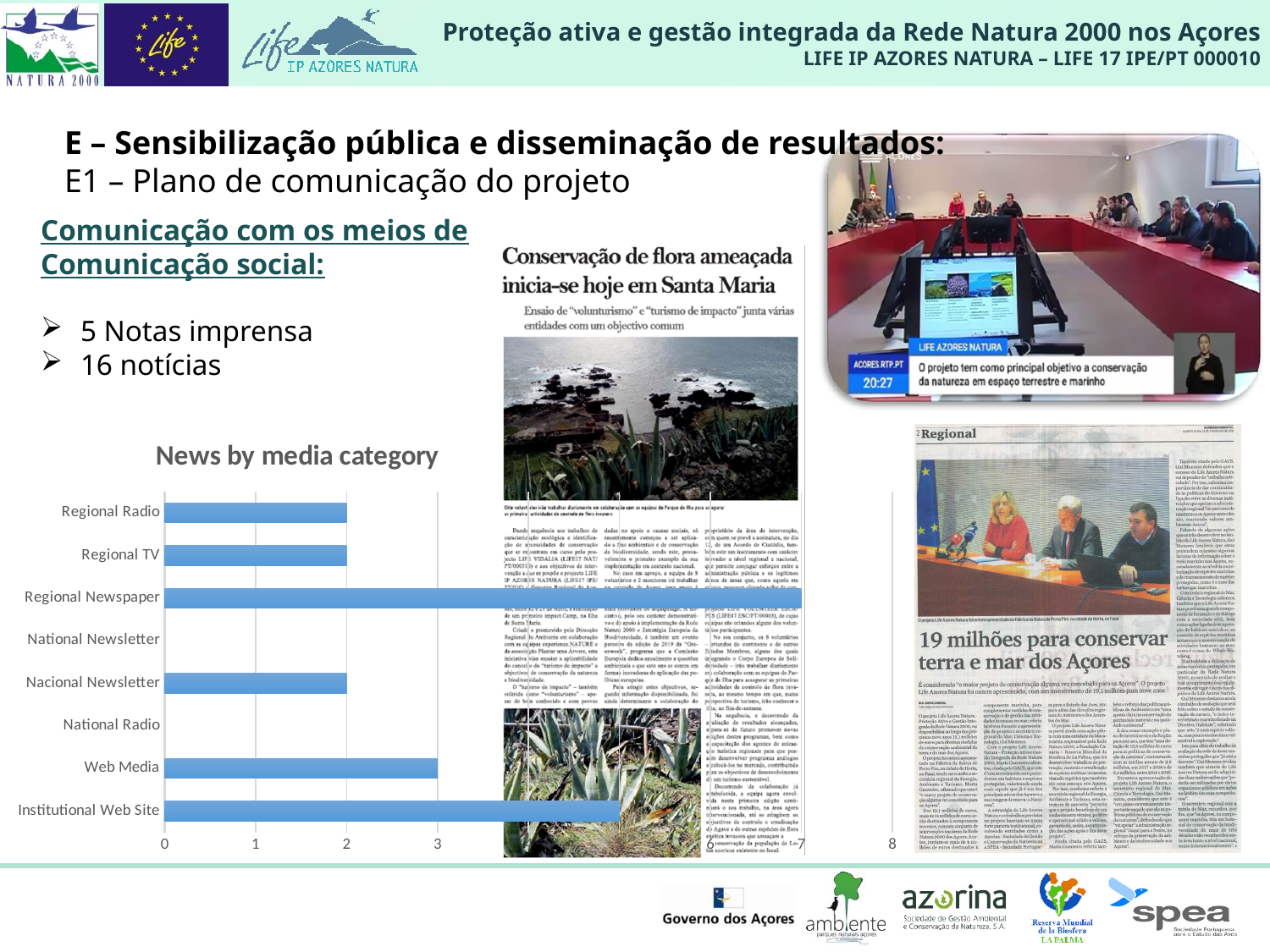
In the "News by media category" chart, is the value for Institutional Web Site greater or less than 3? greater In the "News by media category" chart, which has a higher value, Web Media or Regional Radio? Web Media What type of chart is shown under the title "News by media category"? bar chart In the "News by media category" chart, what is the value for Regional Radio? 2 What is the title of the bar chart on the slide? News by media category In the "News by media category" chart, is the value for Regional Newspaper greater or less than 3? greater In the "News by media category" chart, what is the value for Web Media? 3 How many media categories are shown in the "News by media category" chart? 8 In the "News by media category" chart, what is the value for Regional TV? 2